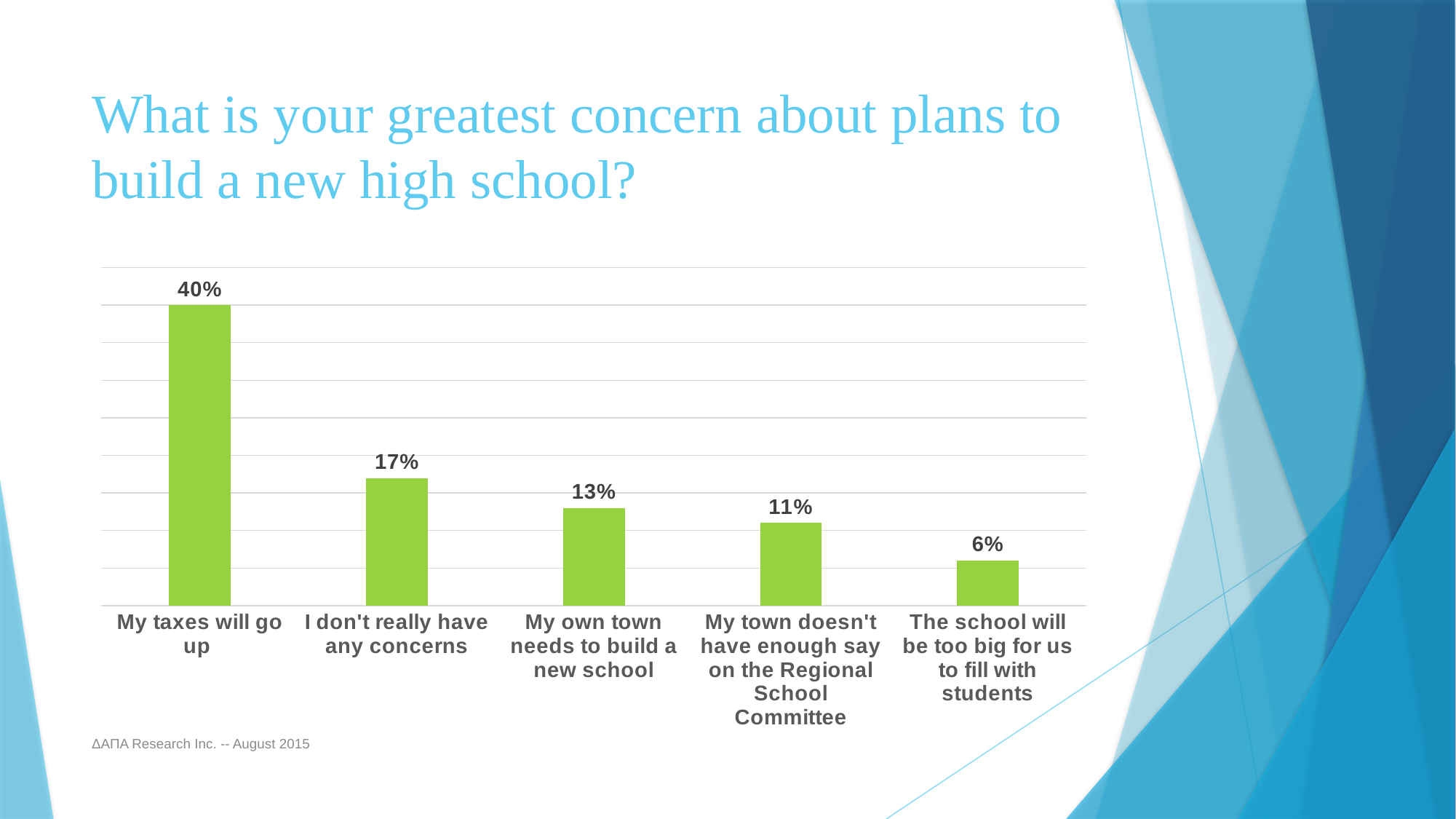
How many categories are shown in the chart? 5 Which is larger: "My own town needs to build a new school" or "My town doesn't have enough say on the Regional School Committee"? My own town needs to build a new school What is the difference between "My taxes will go up" and "I don't really have any concerns"? 23% What percentage of respondents said "My taxes will go up"? 40% What is the value for "The school will be too big for us to fill with students"? 6% What is the value for "I don't really have any concerns"? 17% Which concern has the lowest percentage? The school will be too big for us to fill with students What is the difference between "My town doesn't have enough say on the Regional School Committee" and "The school will be too big for us to fill with students"? 5% Do the values rise or fall from left to right across the categories? Fall What kind of chart is shown on the slide? Bar chart What percentage chose "My own town needs to build a new school"? 13% Which concern has the highest percentage? My taxes will go up